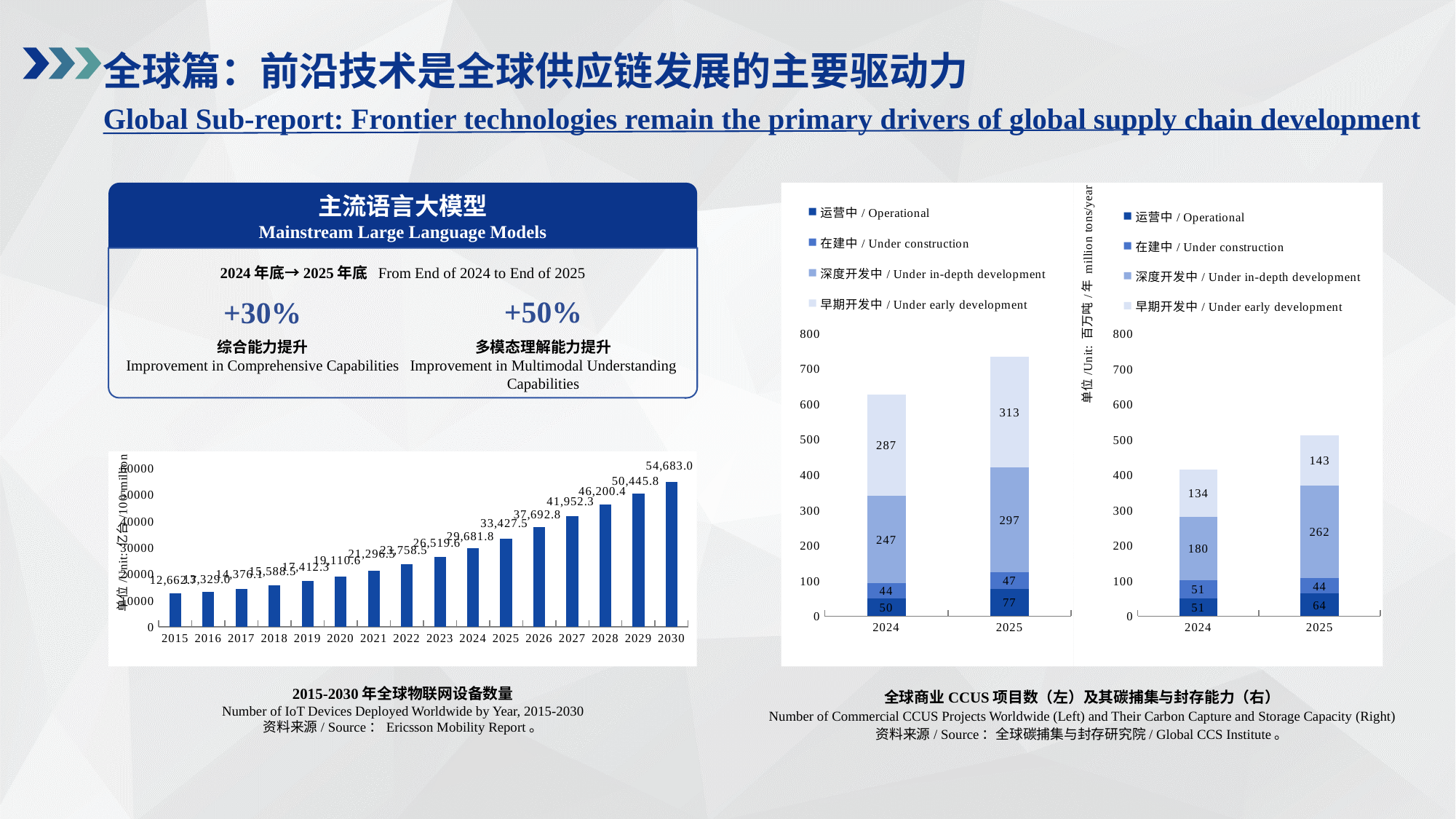
In the CCUS capacity chart (right stacked chart), how many series does the legend list? 4 In the CCUS capacity chart (right stacked chart), what is the Under construction value for 2025? 44 In the IoT devices chart (bottom left), which year has the highest value? 2030 In the CCUS projects chart (left stacked chart), is the Operational value larger for 2024 or 2025? 2025 In the CCUS capacity chart (right stacked chart), what is the total of the 2025 stacked bar? 513 In the IoT devices chart (bottom left), what is the value for 2025? 33,427.5 In the IoT devices chart (bottom left), what is the value for 2030? 54,683.0 In the IoT devices chart (bottom left), do the values rise or fall from 2015 to 2030? rise In the IoT devices chart (bottom left), what is the difference between the 2030 and 2029 values? 4,237.2 In the CCUS projects chart (left stacked chart), what is the Under in-depth development value for 2025? 297 In the CCUS projects chart (left stacked chart), what is the total of the 2024 stacked bar? 628 In the IoT devices chart (bottom left), how many years are plotted? 16